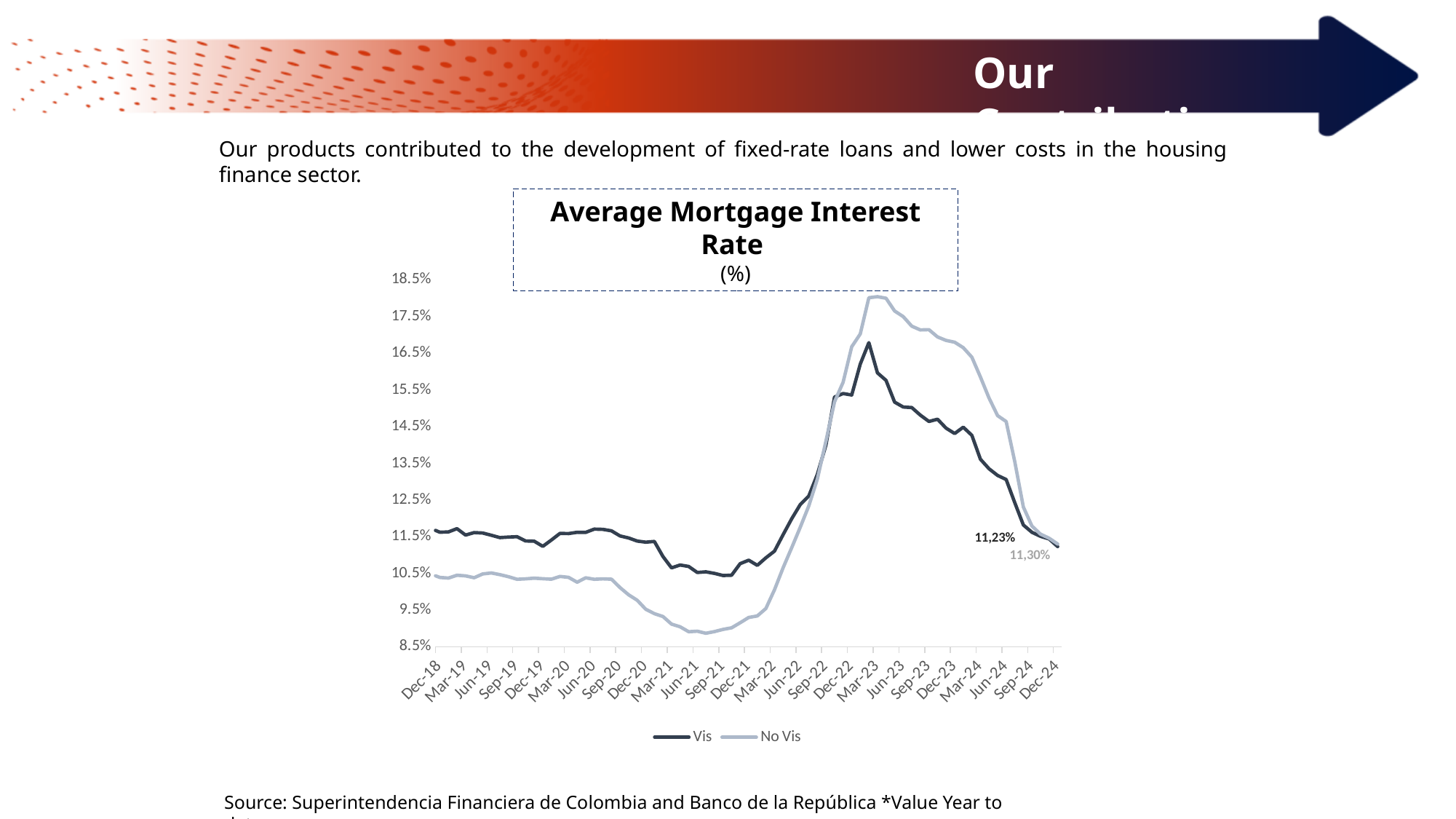
Is the value of the Vis series at Dec-18 greater or less than 10.5%? greater What is the value of the Vis series at Dec-24? 11,23% What is the value of the No Vis series at Dec-24? 11,30% Does the Vis series rise or fall between Mar-23 and Dec-24? fall What is the difference between the No Vis and Vis values at Dec-24? 0,07% Is the value of the No Vis series at Jun-21 greater or less than 9.5%? less Is the value of the No Vis series at Mar-23 greater or less than 17.5%? greater What are the two series named in the legend? Vis and No Vis At Dec-24, which series has the higher value, Vis or No Vis? No Vis How many series does the legend list? 2 What kind of chart is shown on the slide? line chart What is the title of the chart? Average Mortgage Interest Rate (%)